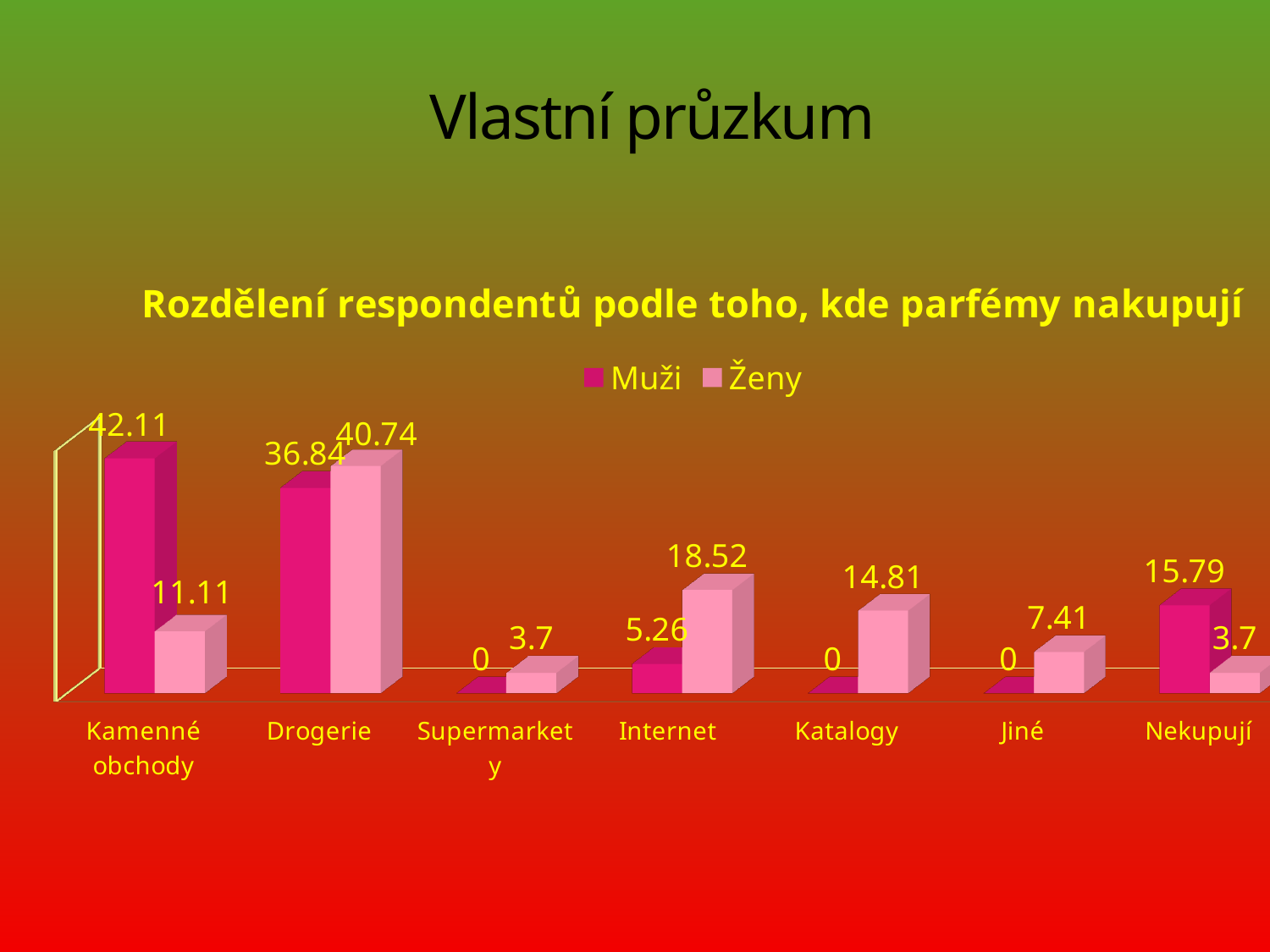
What is the value for Muži in the Kamenné obchody category? 42.11 What type of chart is shown on the slide? bar chart What is the difference between the Muži and Ženy values in the Kamenné obchody category? 31 Which category has the highest value for Muži? Kamenné obchody What is the value for Muži in the Nekupují category? 15.79 What is the title of the chart? Rozdělení respondentů podle toho, kde parfémy nakupují Which is larger in the Drogerie category, the Muži value or the Ženy value? Ženy How many categories are shown on the x axis? 7 What is the value for Ženy in the Katalogy category? 14.81 What is the value for Ženy in the Internet category? 18.52 How many series does the legend list? 2 Which category has the highest value for Ženy? Drogerie